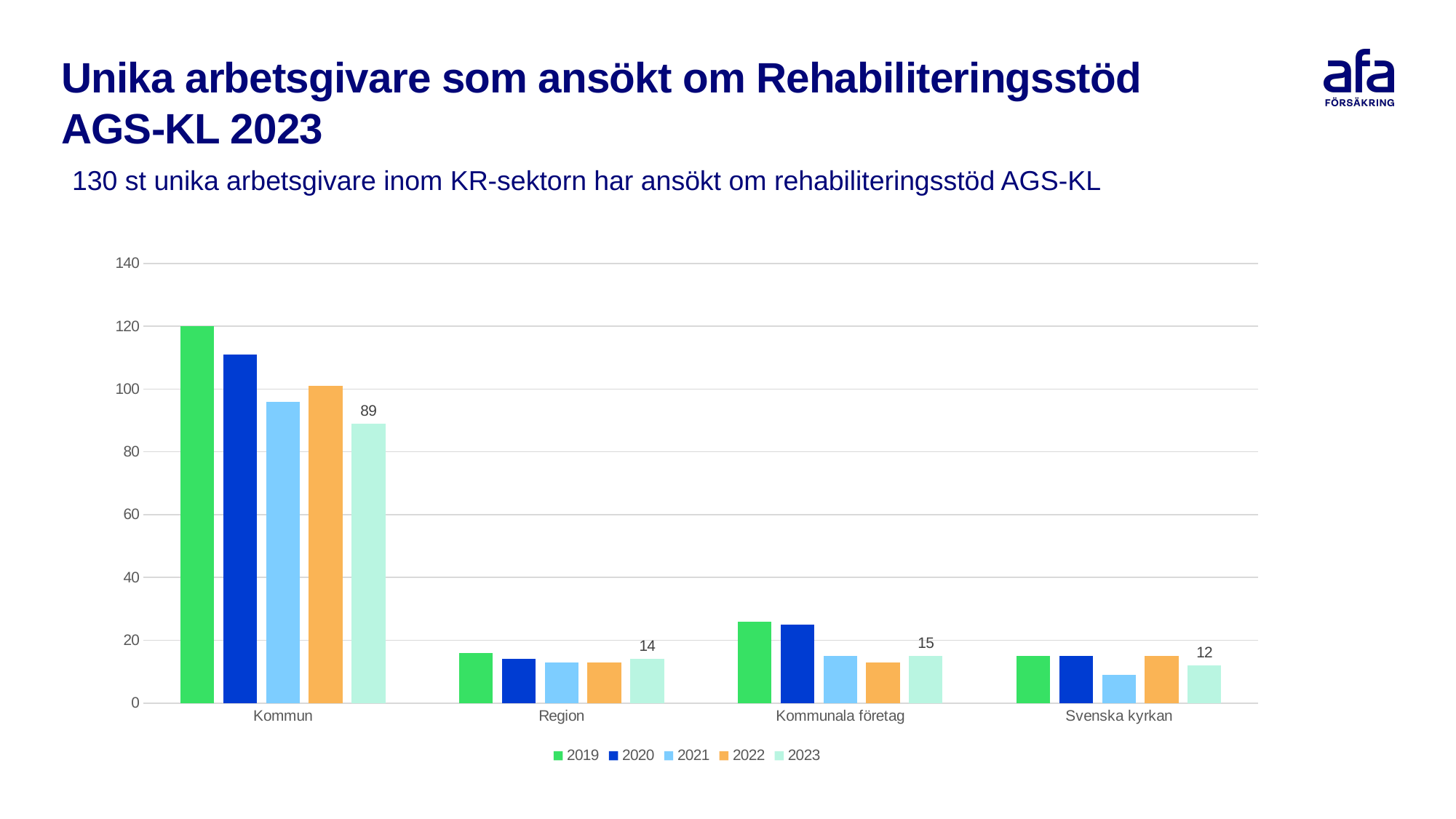
Which category has the lowest 2023 value? Svenska kyrkan What kind of chart is shown on the slide? Bar chart How many categories are shown on the x axis? 4 What is the value for Kommunala företag in 2023? 15 What is the value for Region in 2023? 14 How many series does the legend list? 5 What is the difference between the 2023 values for Kommun and Region? 75 Which category has the highest 2023 value? Kommun What is the value for Kommun in 2023? 89 Is the value for Kommun in 2019 greater or less than 100? greater Is the value for Kommunala företag in 2019 greater or less than 40? less What is the value for Svenska kyrkan in 2023? 12